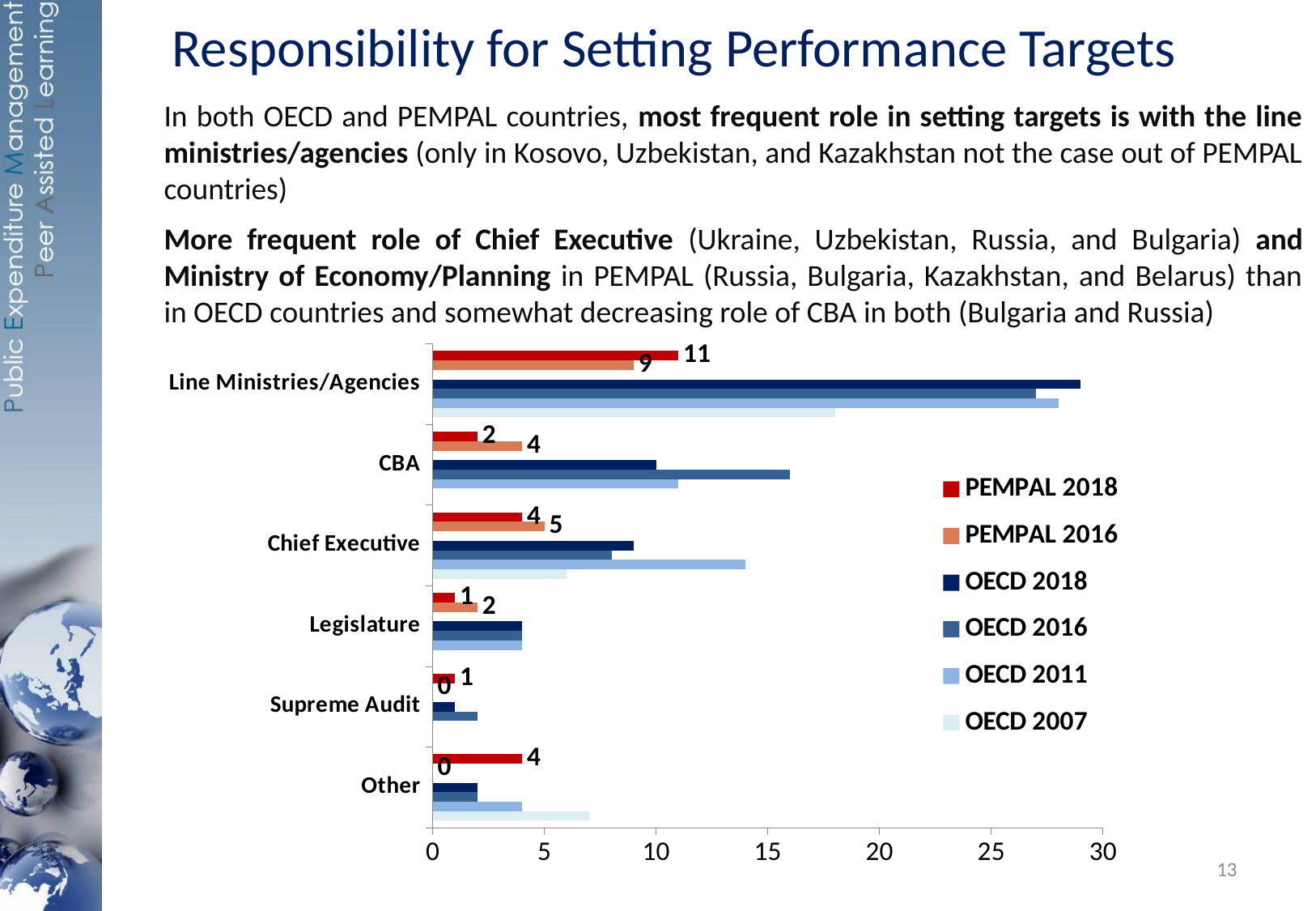
How many series does the legend list? 6 What kind of chart is shown on the slide? bar chart Which is larger for Legislature, the PEMPAL 2018 value or the PEMPAL 2016 value? PEMPAL 2016 Is the OECD 2018 value for Line Ministries/Agencies greater or less than 25? greater What is the PEMPAL 2018 value for Line Ministries/Agencies? 11 What is the PEMPAL 2016 value for Chief Executive? 5 Is the OECD 2007 value for Line Ministries/Agencies greater or less than 20? less What is the difference between the PEMPAL 2016 and PEMPAL 2018 values for CBA? 2 Which category has the highest PEMPAL 2018 value? Line Ministries/Agencies What is the PEMPAL 2018 value for Other? 4 How many categories are shown on the chart? 6 What is the PEMPAL 2016 value for Line Ministries/Agencies? 9